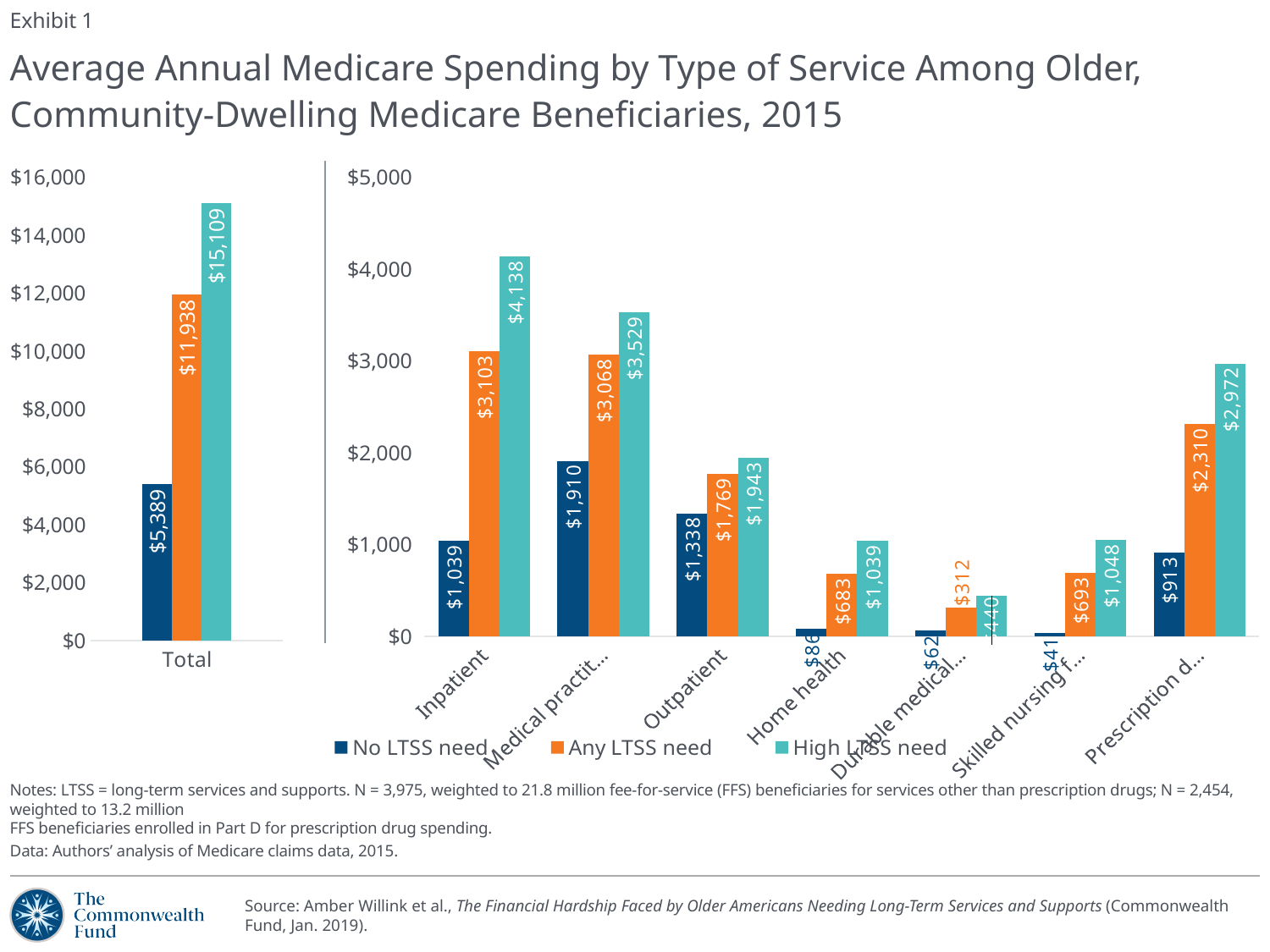
In the left chart (Total), what is the value for No LTSS need? $5,389 In the left chart (Total), what is the difference between the Any LTSS need and No LTSS need values? $6,549 How many service categories are shown on the x axis of the right chart? 7 How many series does the legend list? 3 In the right chart, what is the Any LTSS need value for Inpatient? $3,103 What kind of chart is shown on the slide? Bar chart In the right chart, which service category has the highest High LTSS need value? Inpatient In the right chart, what is the High LTSS need value for Outpatient? $1,943 In the left chart (Total), what is the value for High LTSS need? $15,109 In the right chart, which is larger for Outpatient: the No LTSS need value or the Any LTSS need value? Any LTSS need In the right chart, what is the No LTSS need value for Home health? $86 In the right chart, is the High LTSS need value for Inpatient greater or less than $4,000? greater